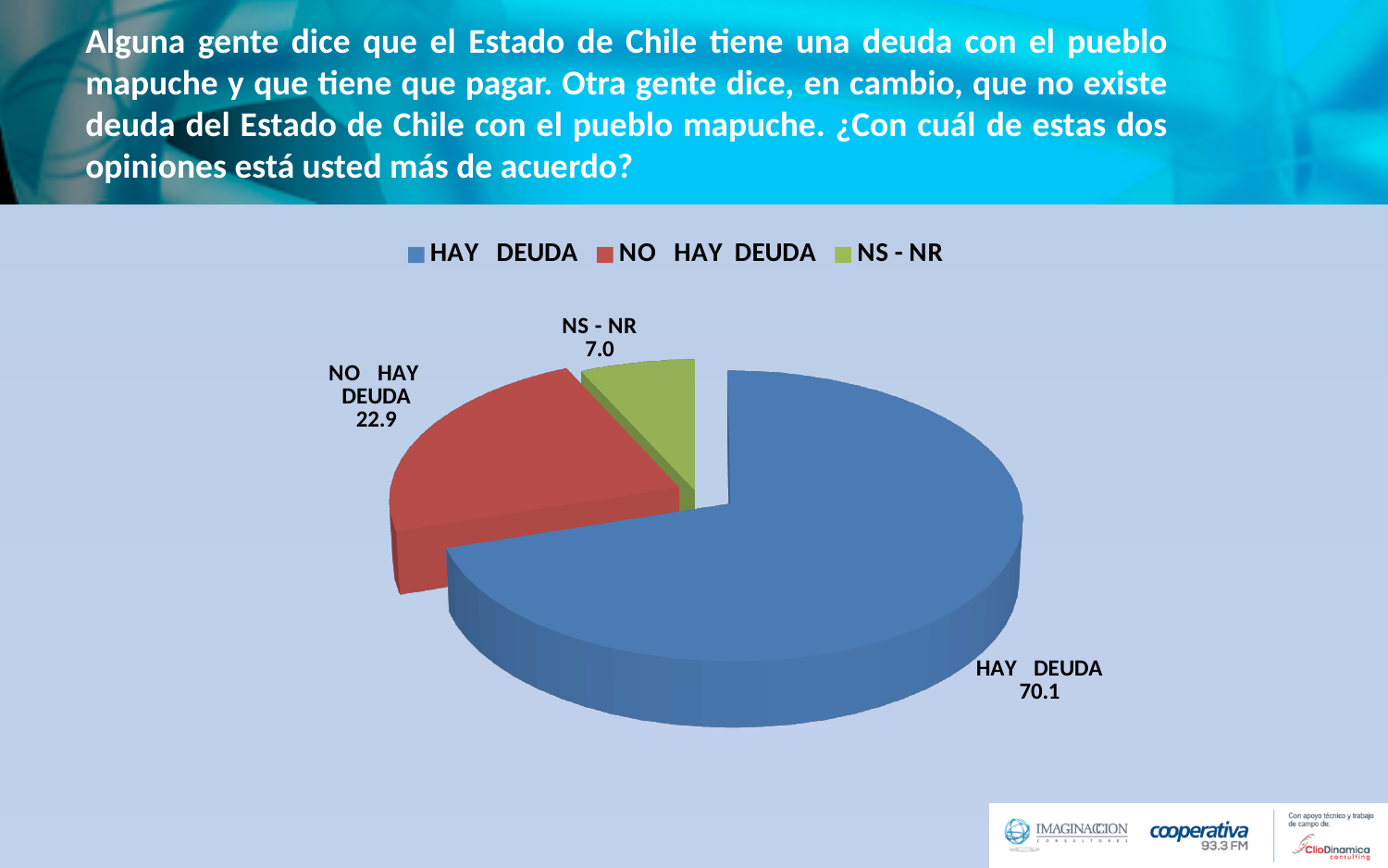
Which is larger, the value for NO HAY DEUDA or the value for NS - NR? NO HAY DEUDA What is the difference between the values for NO HAY DEUDA and NS - NR? 15.9 What is the value for HAY DEUDA? 70.1 What kind of chart is shown on the slide? Pie chart What is the value for NS - NR? 7.0 What is the value for NO HAY DEUDA? 22.9 What is the difference between the values for HAY DEUDA and NO HAY DEUDA? 47.2 Which category has the largest slice? HAY DEUDA How many slices does the pie chart have? 3 How many entries does the legend list? 3 Which category has the smallest slice? NS - NR What colour is the HAY DEUDA slice? Blue